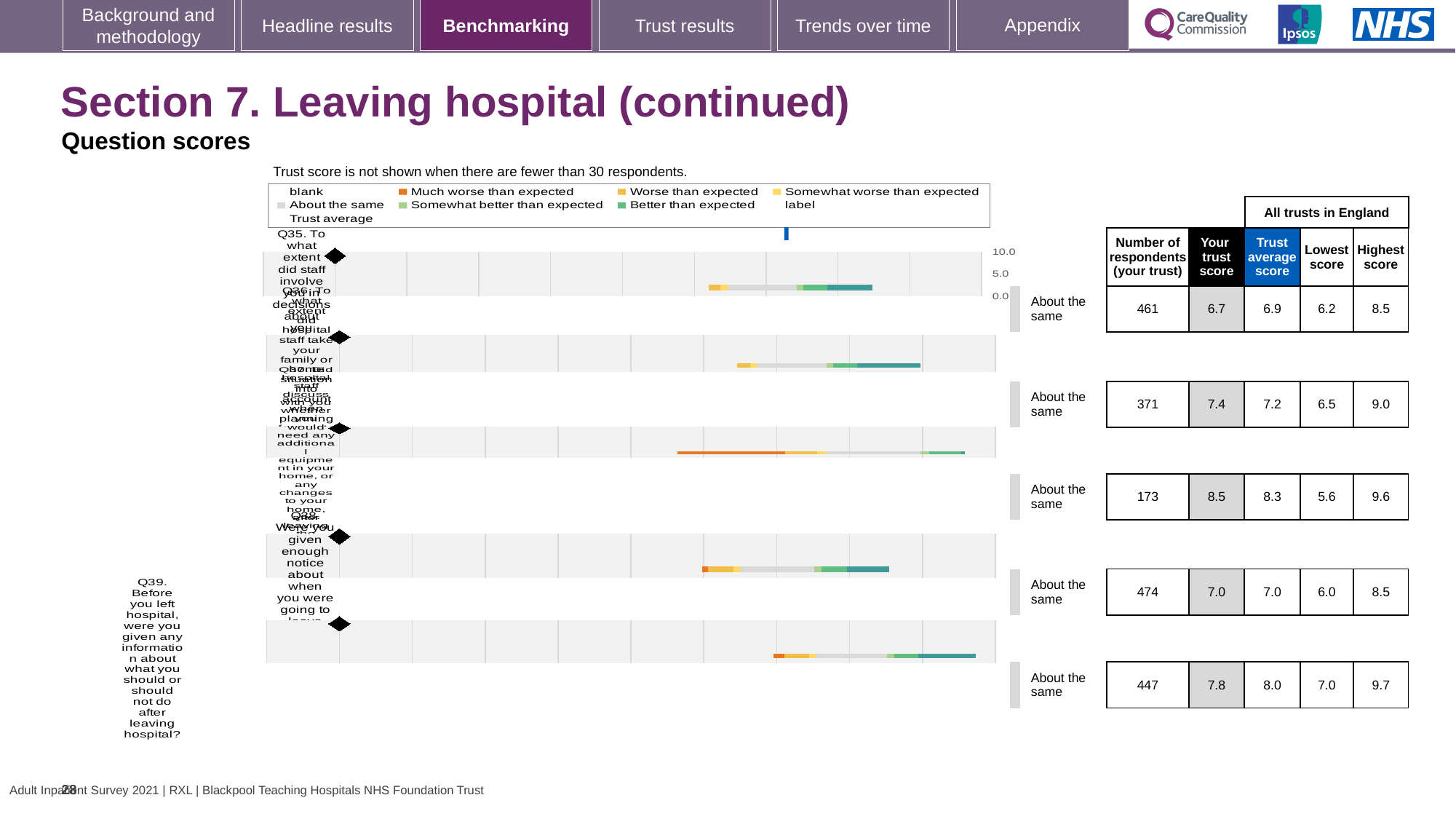
What kind of chart is used to show the question scores? Bar chart Which question has the lowest 'Your trust score' on this slide? Q35 Which question has the highest 'Your trust score' on this slide? Q37 What is the 'Your trust score' for Q35 (To what extent did staff involve you in decisions about you leaving hospital)? 6.7 For Q39, which is larger: the 'Your trust score' or the 'Trust average score'? Trust average score How many respondents from your trust answered Q36? 371 What is the lowest score across all trusts in England for Q37? 5.6 What is the highest score across all trusts in England for Q39? 9.7 How many questions are shown on this slide? 5 What is the 'Trust average score' for Q37? 8.3 What benchmark category is shown for Q38? About the same What is the difference between the 'Your trust score' and the 'Trust average score' for Q36? 0.2